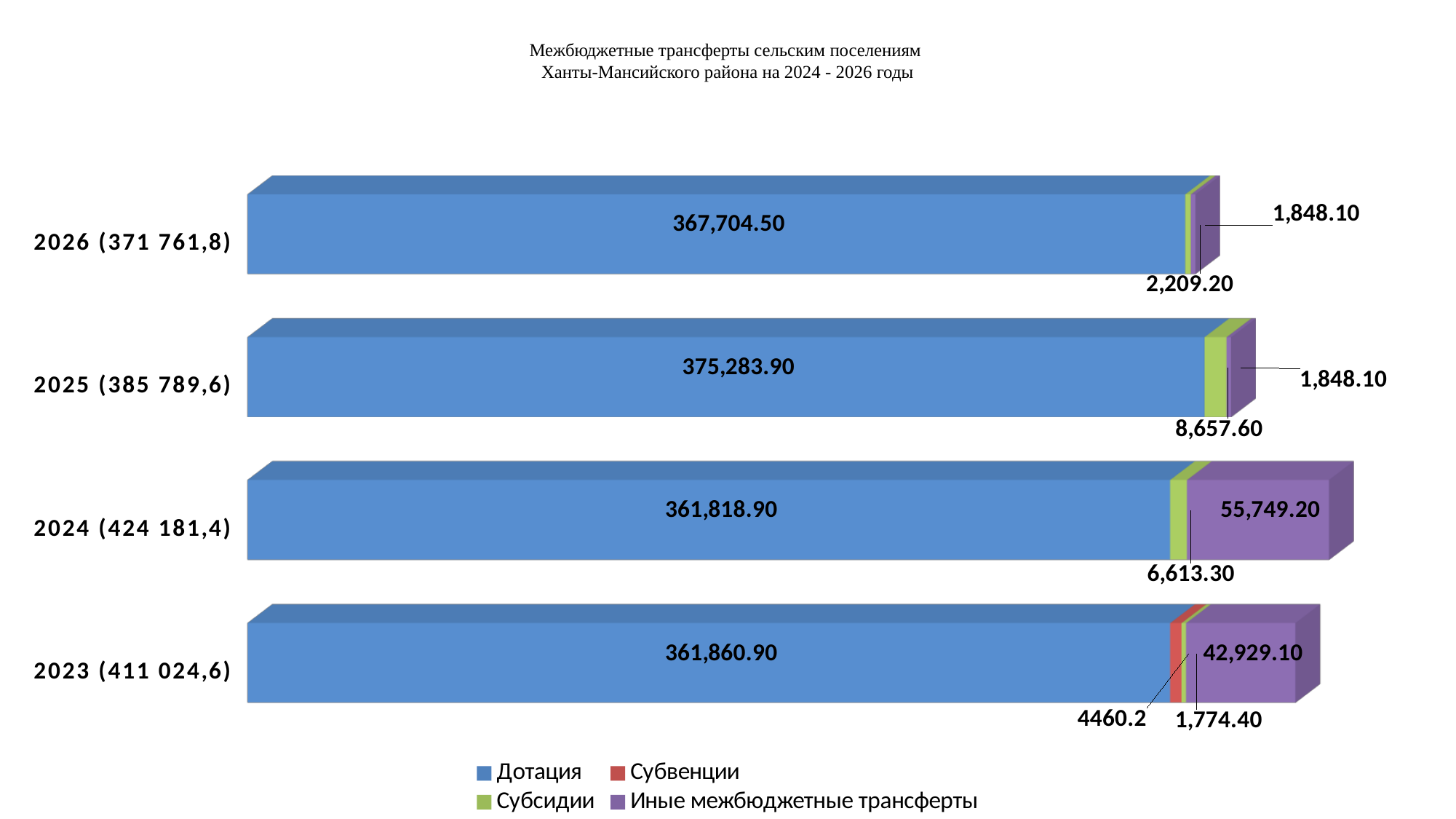
What colour represents Субвенции in the legend? Red What is the difference between Иные межбюджетные трансферты in 2024 and in 2023? 12,820.10 What kind of chart is shown on the slide? Stacked bar chart How many years are shown on the chart? 4 What is the value of Иные межбюджетные трансферты for 2024? 55,749.20 How many series does the legend list? 4 What is the value of Субсидии for 2025? 8,657.60 Which year has the lowest value for Субсидии? 2023 Which is larger: Дотация in 2025 or Дотация in 2026? 2025 Which year has the highest value for Дотация? 2025 What is the value of Субвенции for 2023? 4460.2 What is the value of Дотация for 2025? 375,283.90